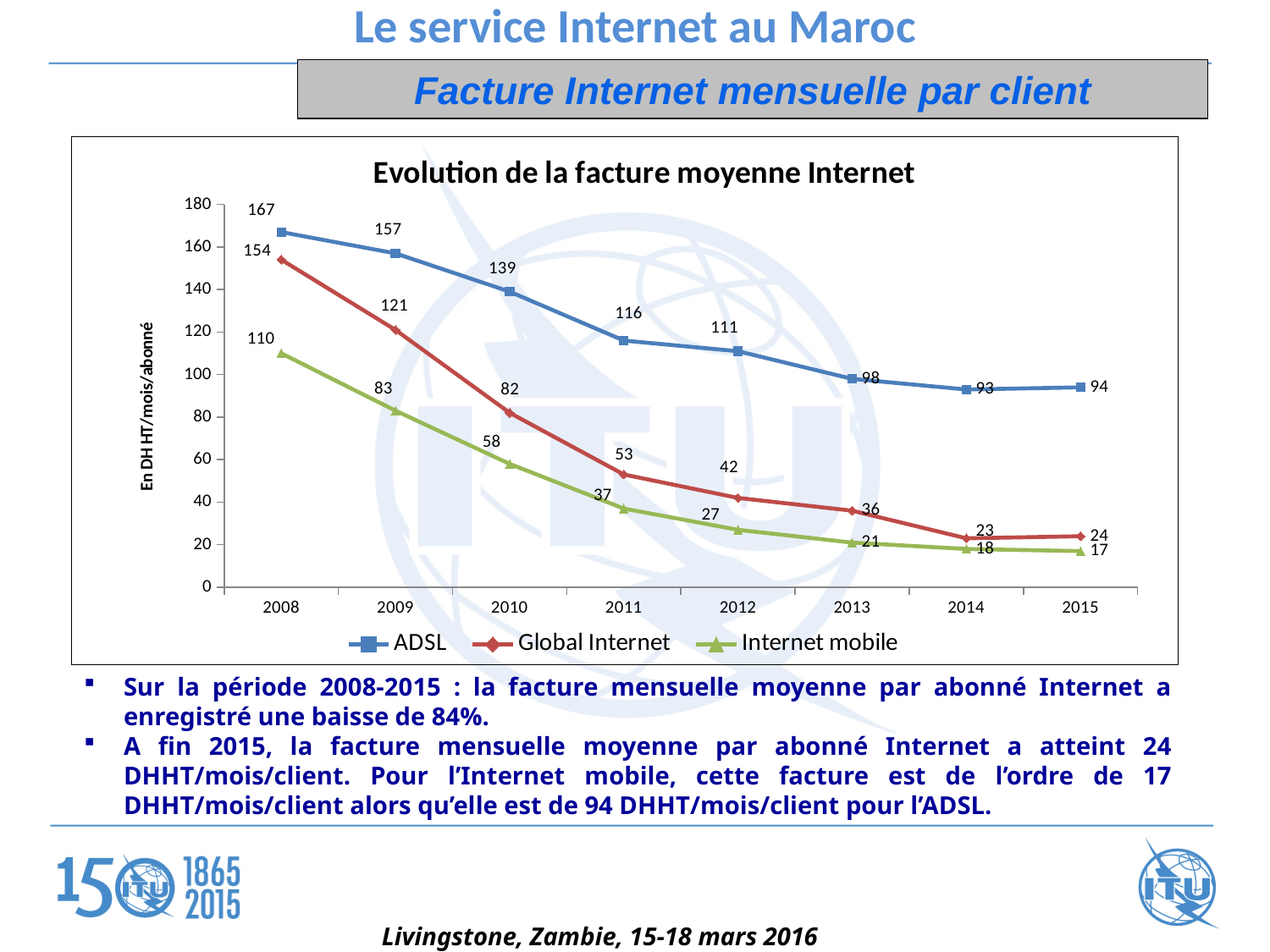
Do the ADSL values rise or fall from 2008 to 2015? fall In which year is the ADSL value lowest? 2014 What is the ADSL value for 2008? 167 How many years are shown on the x axis? 8 Which is larger in 2011: the Global Internet value or the Internet mobile value? Global Internet What kind of chart is this? line chart What is the difference between the Global Internet value in 2008 and in 2015? 130 What is the difference between the ADSL value and the Global Internet value in 2015? 70 What is the Global Internet value for 2012? 42 How many series does the legend list? 3 What is the Internet mobile value for 2015? 17 In which year is the Internet mobile value highest? 2008